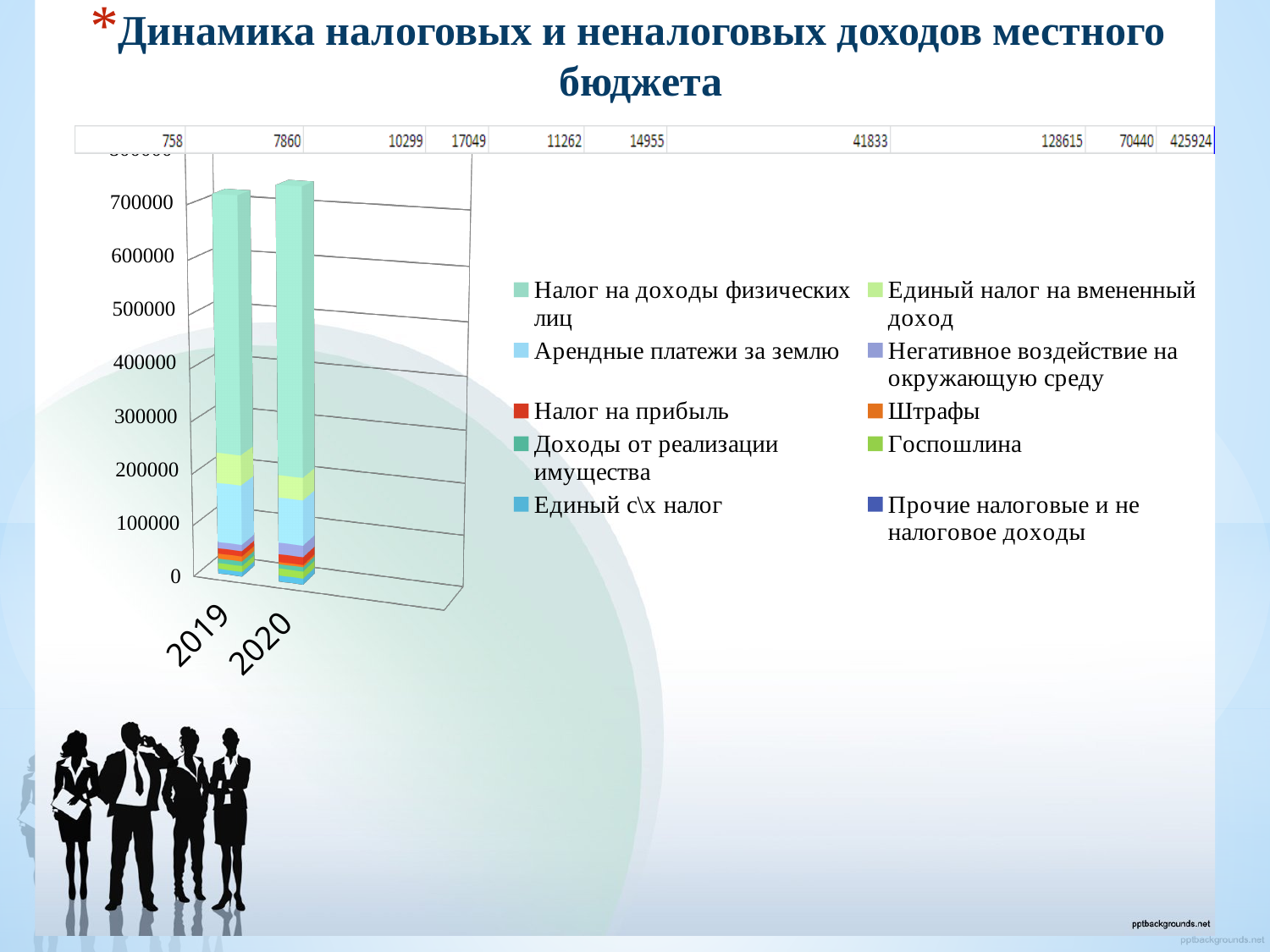
What kind of chart is shown on the slide? Stacked bar chart Is the total height of the 2020 bar greater or less than 800000? less How many years (categories) are shown on the x axis of the chart? 2 What is the title of the chart on the slide? Динамика налоговых и неналоговых доходов местного бюджета Is the total height of the 2019 bar greater or less than 600000? greater How many series does the chart legend list? 10 Which years are shown on the x axis of the chart? 2019 and 2020 Is the total height of the 2020 bar greater or less than 500000? greater Which series makes up the largest segment of the bars in both years? Налог на доходы физических лиц